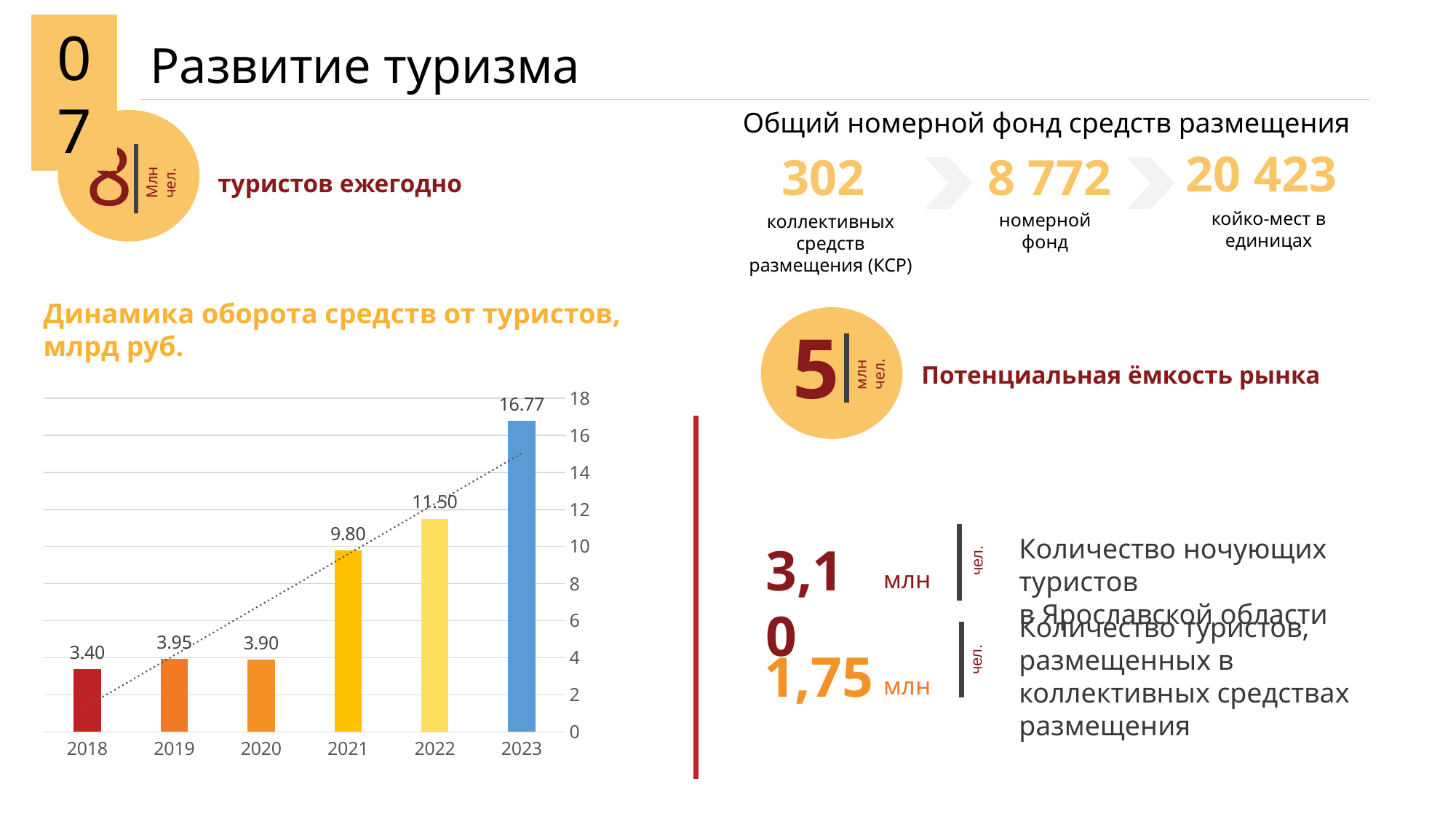
What is the difference between the 2023 and 2022 values in the chart 'Динамика оборота средств от туристов, млрд руб.'? 5.27 What kind of chart is 'Динамика оборота средств от туристов, млрд руб.'? bar chart Which year has the lowest value in the chart 'Динамика оборота средств от туристов, млрд руб.'? 2018 Which year has the highest value in the chart 'Динамика оборота средств от туристов, млрд руб.'? 2023 Do the values in the chart 'Динамика оборота средств от туристов, млрд руб.' generally rise or fall from 2018 to 2023? rise In the chart 'Динамика оборота средств от туристов, млрд руб.', which is larger: the value for 2019 or the value for 2020? 2019 What is the value for 2021 in the chart 'Динамика оборота средств от туристов, млрд руб.'? 9.80 In the chart 'Динамика оборота средств от туристов, млрд руб.', is the value for 2022 greater or less than 10? greater What is the value for 2023 in the chart 'Динамика оборота средств от туристов, млрд руб.'? 16.77 What is the maximum value shown on the y axis of the chart 'Динамика оборота средств от туристов, млрд руб.'? 18 How many years are shown on the x axis of the chart 'Динамика оборота средств от туристов, млрд руб.'? 6 What is the value for 2018 in the chart 'Динамика оборота средств от туристов, млрд руб.'? 3.40